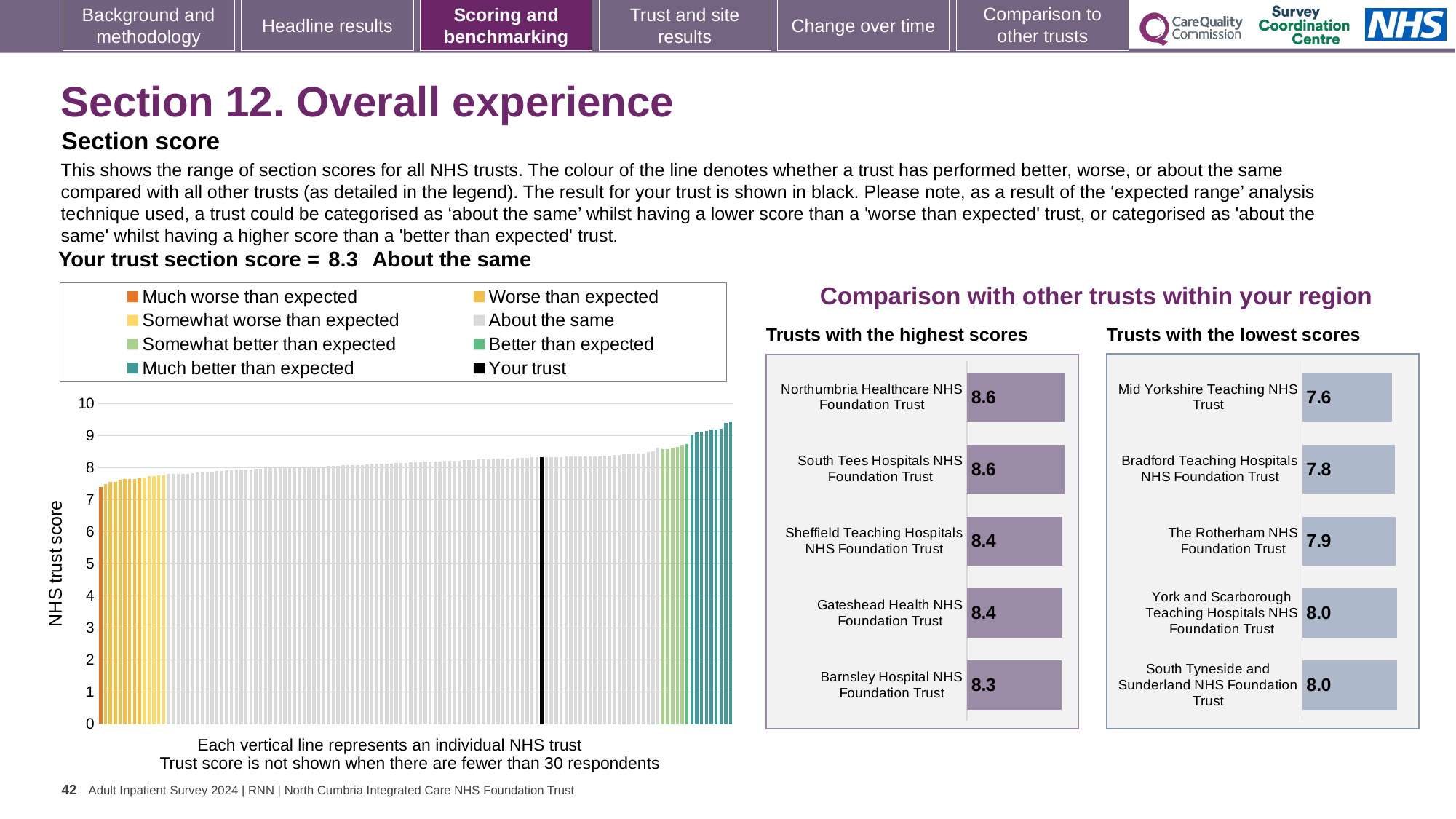
In the 'Trusts with the lowest scores' chart, which trust has the lowest score? Mid Yorkshire Teaching NHS Trust In the 'Trusts with the lowest scores' chart, what is the difference between the scores of South Tyneside and Sunderland NHS Foundation Trust and Mid Yorkshire Teaching NHS Trust? 0.4 How many entries does the legend of the NHS trust score chart on the left list? 8 What kind of chart is the NHS trust score chart on the left of the slide? Bar chart In the NHS trust score chart on the left, is the value for your trust (the black line) greater or less than 8? greater In the 'Trusts with the highest scores' chart, what is the difference between the scores of Northumbria Healthcare NHS Foundation Trust and Barnsley Hospital NHS Foundation Trust? 0.3 What is the section score for your trust shown on the slide? 8.3 In the 'Trusts with the lowest scores' chart, what is the score for Mid Yorkshire Teaching NHS Trust? 7.6 In the NHS trust score chart on the left, do the values rise or fall from left to right? Rise In the 'Trusts with the highest scores' chart, what is the score for Sheffield Teaching Hospitals NHS Foundation Trust? 8.4 In the 'Trusts with the lowest scores' chart, which has the higher score: Bradford Teaching Hospitals NHS Foundation Trust or The Rotherham NHS Foundation Trust? The Rotherham NHS Foundation Trust How many trusts are listed in the 'Trusts with the highest scores' chart? 5